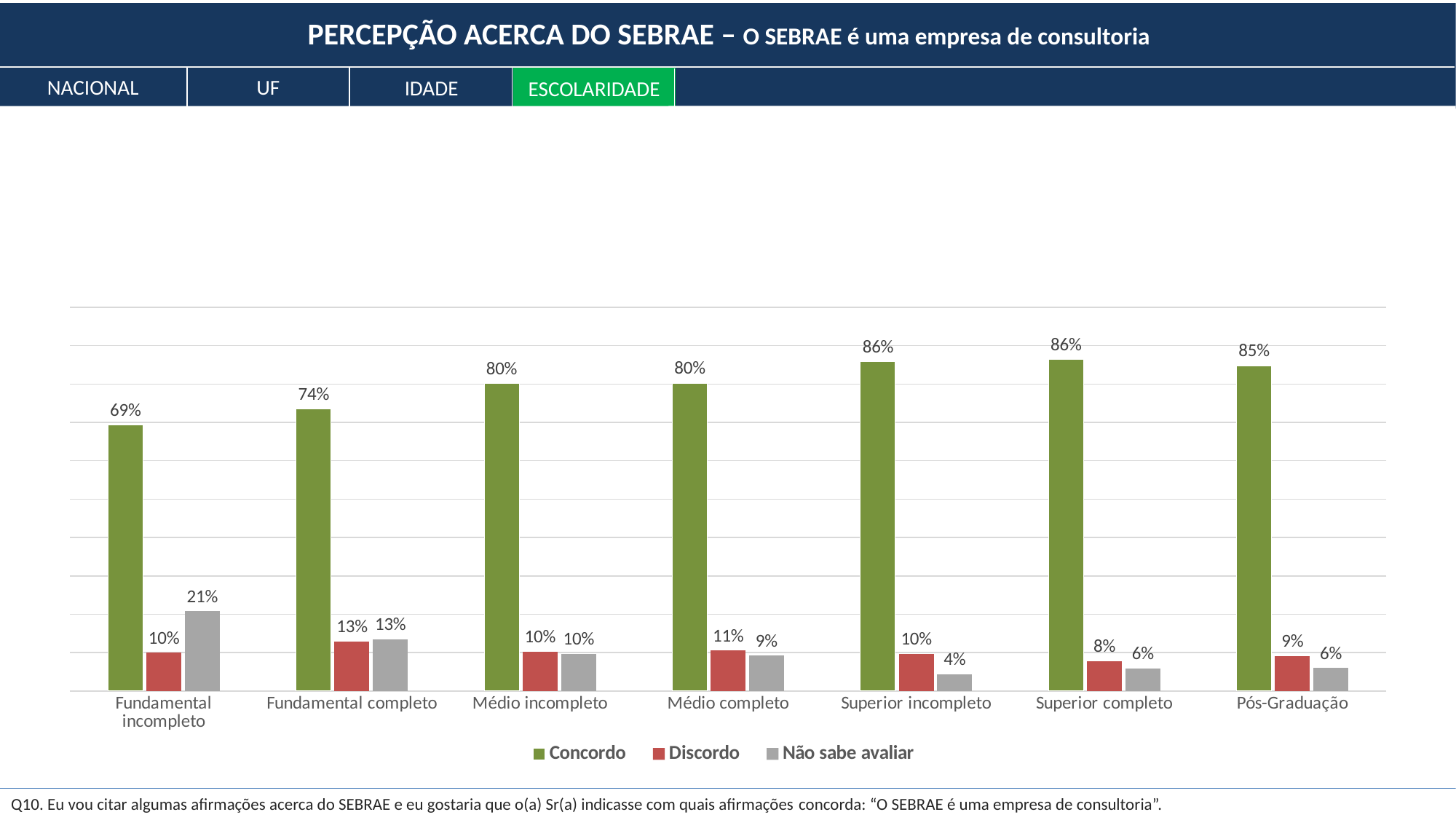
What is the Não sabe avaliar value for Superior incompleto? 4% Which tab is highlighted in green at the top of the slide? ESCOLARIDADE What kind of chart is shown on the slide? Bar chart Which category has the lowest Concordo value? Fundamental incompleto Which is larger, the Concordo value for Pós-Graduação or for Médio incompleto? Pós-Graduação What is the Não sabe avaliar value for Fundamental incompleto? 21% How many series does the legend list? 3 What is the difference between the Concordo values for Superior completo and Fundamental completo? 12% Which category has the highest Não sabe avaliar value? Fundamental incompleto What is the Discordo value for Médio completo? 11% How many education categories are shown on the x axis? 7 What is the Concordo value for Fundamental incompleto? 69%